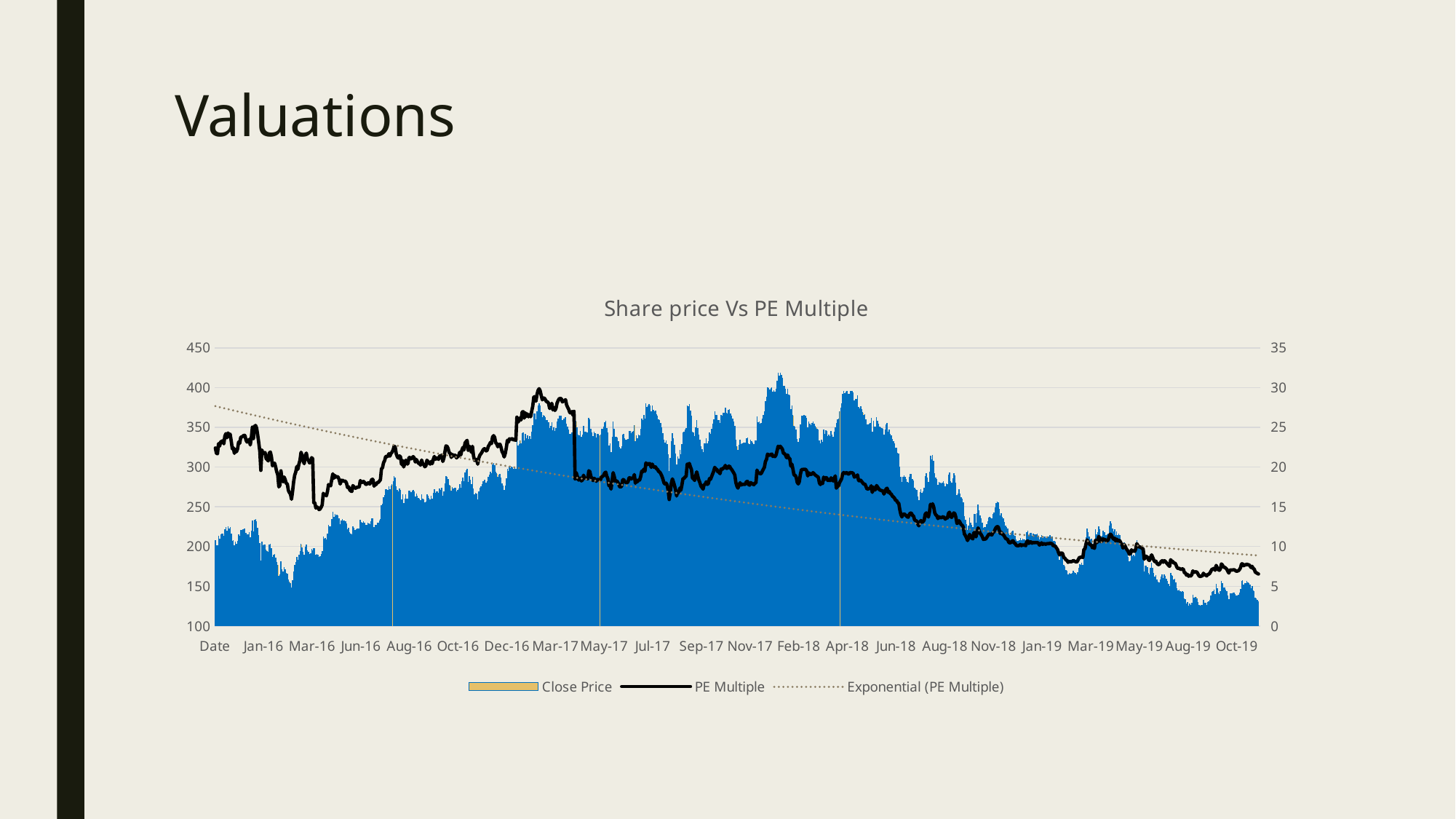
Is the peak PE Multiple value around Mar-17 greater or less than 25? greater What are the three series named in the legend? Close Price, PE Multiple, Exponential (PE Multiple) Is the Close Price around Jan-16 greater or less than 250? less Is the PE Multiple value around Jan-19 greater or less than 15? less What kind of chart is this? Combined bar and line chart What is the title of the chart? Share price Vs PE Multiple How many series does the legend list? 3 Does the PE Multiple line generally rise or fall from Jan-16 to Oct-19? Fall Does the Exponential (PE Multiple) trendline rise or fall across the chart? Fall